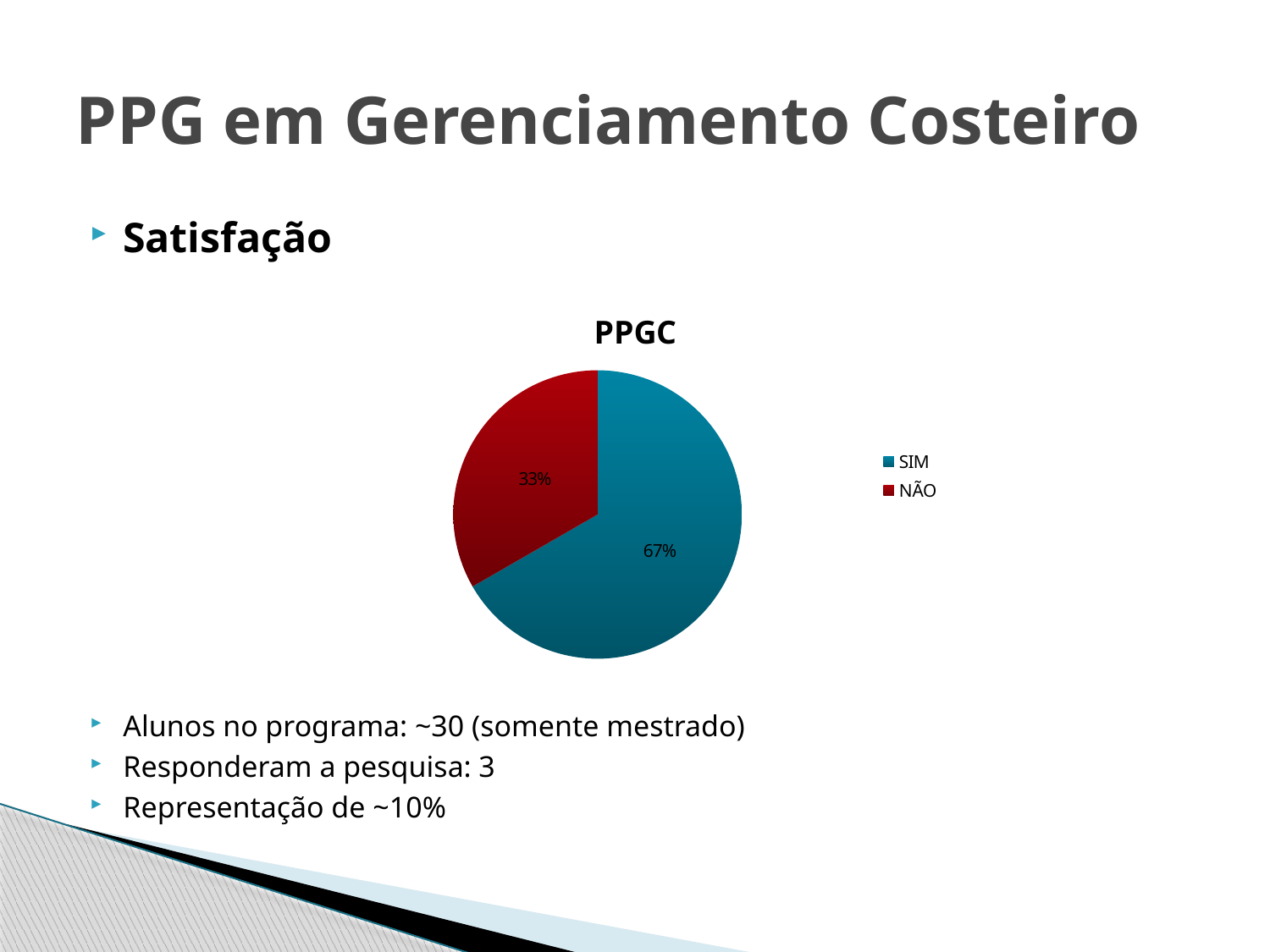
Which slice of the pie is the largest? SIM Which slice of the pie is the smallest? NÃO How many slices does the pie chart have? 2 What colour is the SIM slice? blue How many entries does the legend list? 2 Which is larger, the SIM slice or the NÃO slice? SIM What is the title of the chart? PPGC What kind of chart is shown on the slide? pie chart What share of the pie does NÃO represent? 33% What share of the pie does SIM represent? 67% What is the difference in percentage points between the SIM and NÃO slices? 34